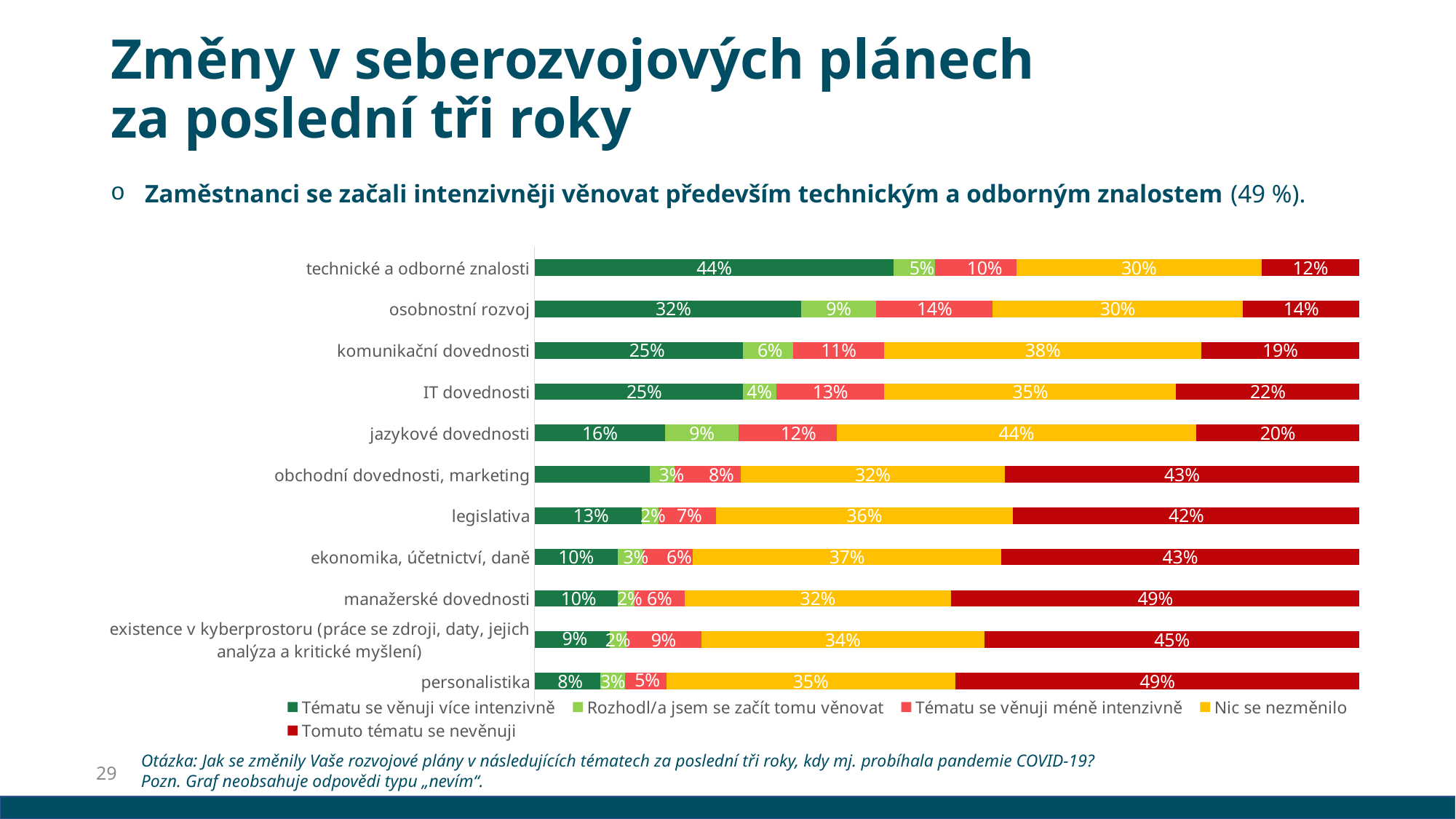
Which category has the lowest value for 'Tomuto tématu se nevěnuji'? technické a odborné znalosti How many series does the legend list? 5 What is the value of 'Tématu se věnuji méně intenzivně' for 'osobnostní rozvoj'? 14% What is the difference between the 'Tomuto tématu se nevěnuji' values for 'personalistika' and 'legislativa'? 7% What is the value of 'Tématu se věnuji více intenzivně' for 'technické a odborné znalosti'? 44% Which colour represents the series 'Nic se nezměnilo' in the legend? yellow Which category has the highest value for 'Tématu se věnuji více intenzivně'? technické a odborné znalosti Which is larger: the 'Nic se nezměnilo' value for 'komunikační dovednosti' or for 'IT dovednosti'? komunikační dovednosti What kind of chart is shown on the slide? stacked bar chart How many categories (topics) are plotted on the chart? 11 What is the value of 'Nic se nezměnilo' for 'jazykové dovednosti'? 44% What is the value of 'Tomuto tématu se nevěnuji' for 'IT dovednosti'? 22%